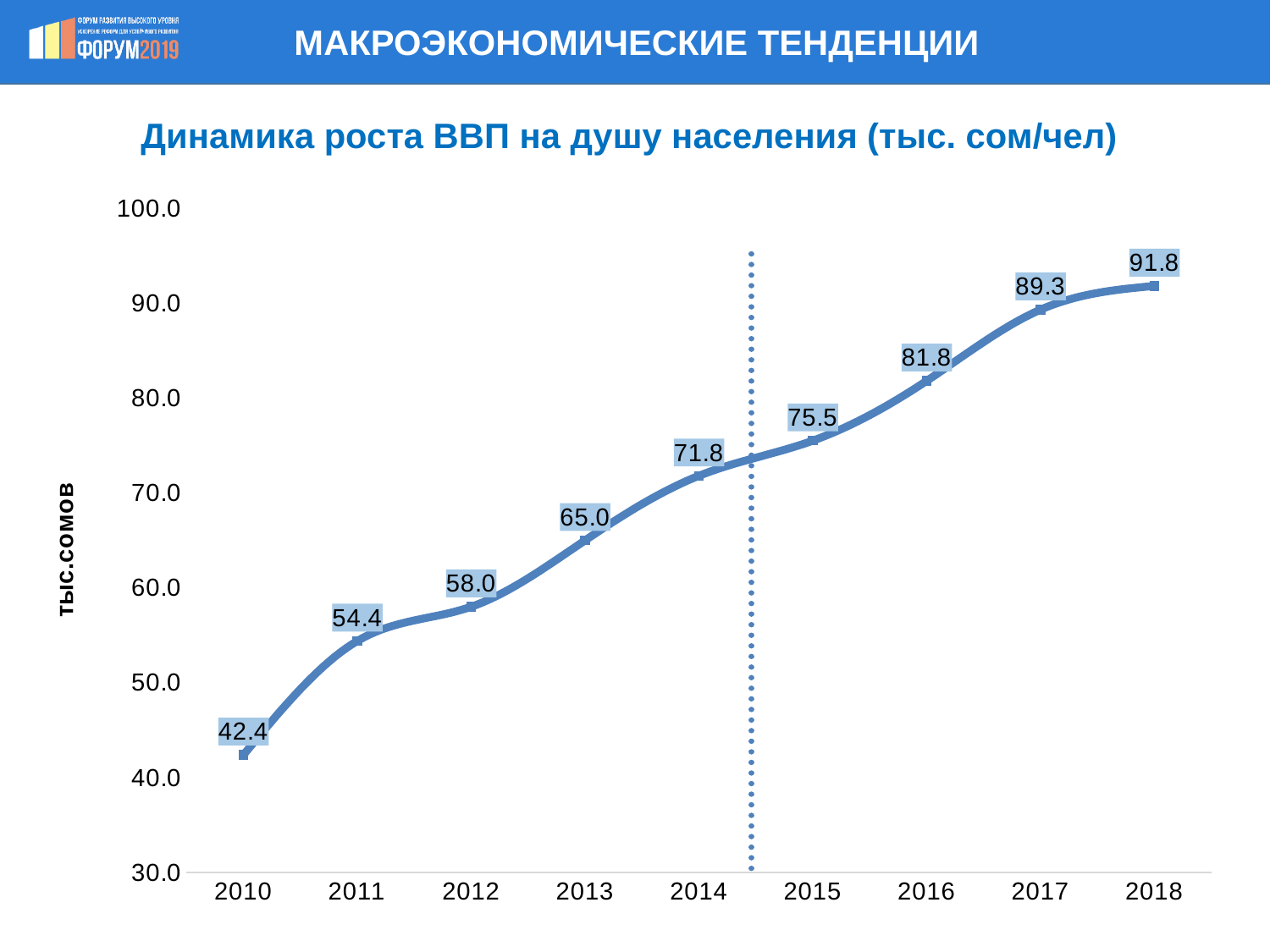
Which year has the lowest value on the chart? 2010 Which is larger, the value for 2012 or the value for 2013? 2013 What is the value plotted for 2017? 89.3 What is the value plotted for 2014? 71.8 What is the difference between the values for 2018 and 2010? 49.4 Do the values rise or fall from 2010 to 2018? rise Which year has the highest value on the chart? 2018 Is the value for 2015 greater or less than 70.0? greater How many years are plotted on the x axis? 9 What is the difference between the values for 2016 and 2015? 6.3 What is the GDP per capita value shown for 2010? 42.4 What kind of chart is shown on the slide? line chart